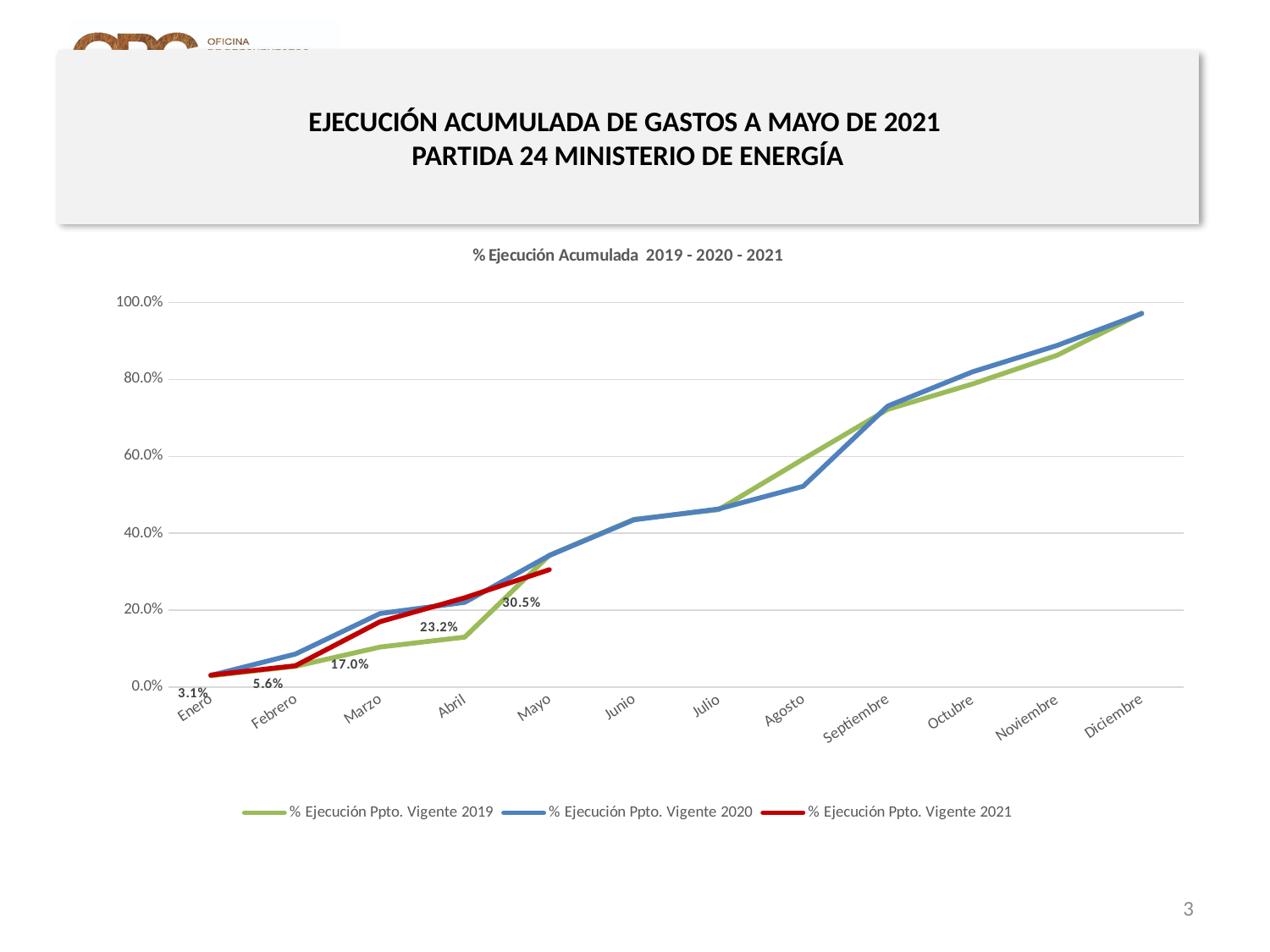
Is the value for % Ejecución Ppto. Vigente 2020 in Diciembre greater or less than 80%? greater What is the difference between the 2021 values for Mayo and Abril? 7.3% What is the value of % Ejecución Ppto. Vigente 2021 for Enero? 3.1% What is the value of % Ejecución Ppto. Vigente 2021 for Mayo? 30.5% How many months are shown on the x axis? 12 What is the difference between the 2021 values for Marzo and Febrero? 11.4% Is the value for % Ejecución Ppto. Vigente 2019 in Abril greater or less than 20%? less Does the % Ejecución Ppto. Vigente 2021 series rise or fall from Enero to Mayo? Rise What is the title of the chart? % Ejecución Acumulada 2019 - 2020 - 2021 What kind of chart is shown on the slide? Line chart What is the value of % Ejecución Ppto. Vigente 2021 for Marzo? 17.0% How many series does the legend list? 3